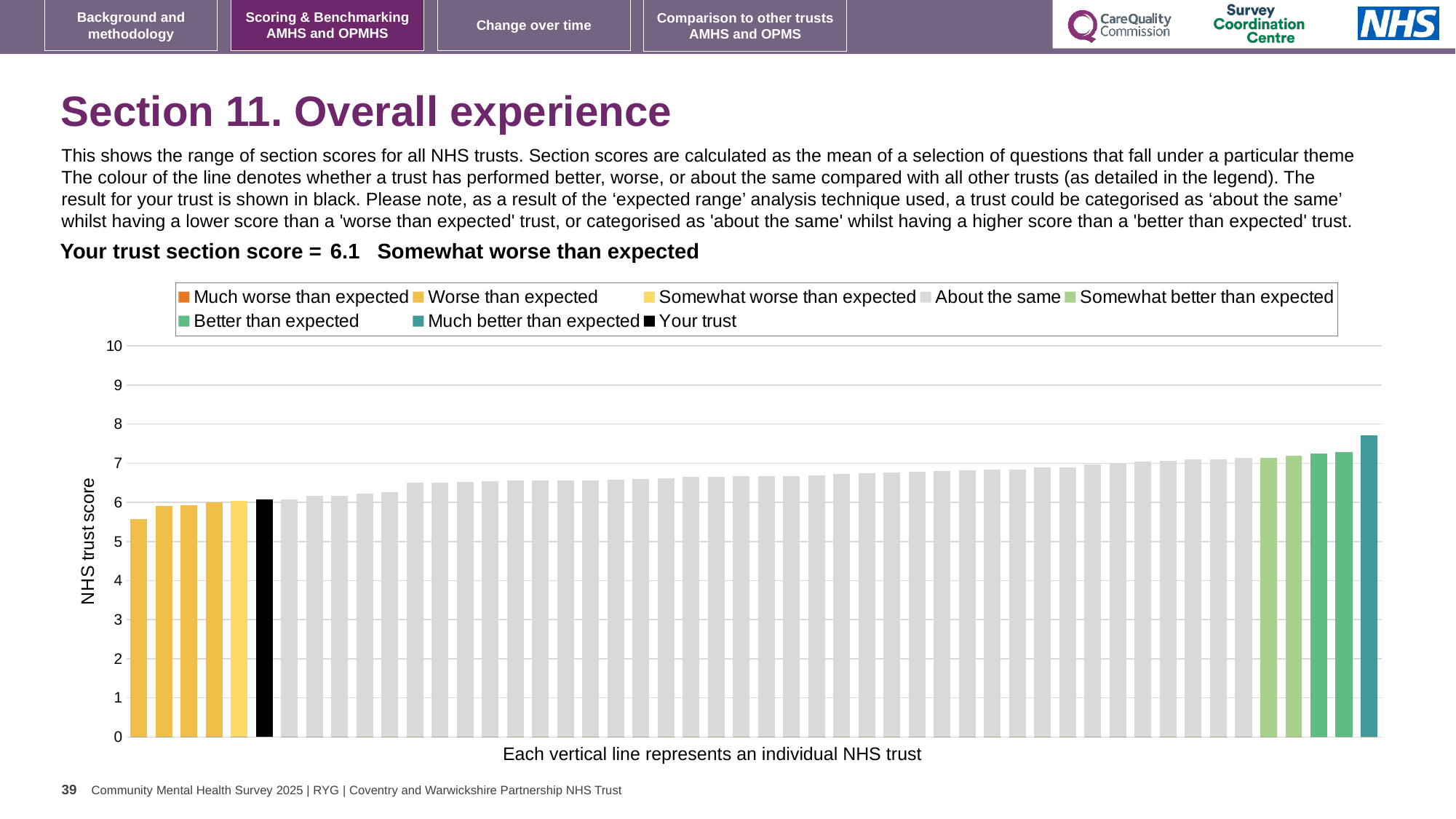
What kind of chart is shown on the slide? Bar chart Which legend category does the shortest bar belong to? Worse than expected Is the value of the shortest bar greater or less than 6? less Do the bar values rise or fall from left to right across the chart? Rise Is the value of the tallest bar greater or less than 7? greater How many bars are coloured as 'Much better than expected'? 1 What is the label on the vertical axis of the chart? NHS trust score What is the section score for your trust? 6.1 How many entries does the chart legend list? 8 Is the value of the tallest bar greater or less than 8? less Which legend category does the tallest bar belong to? Much better than expected Which performance category is your trust placed in for this section? Somewhat worse than expected